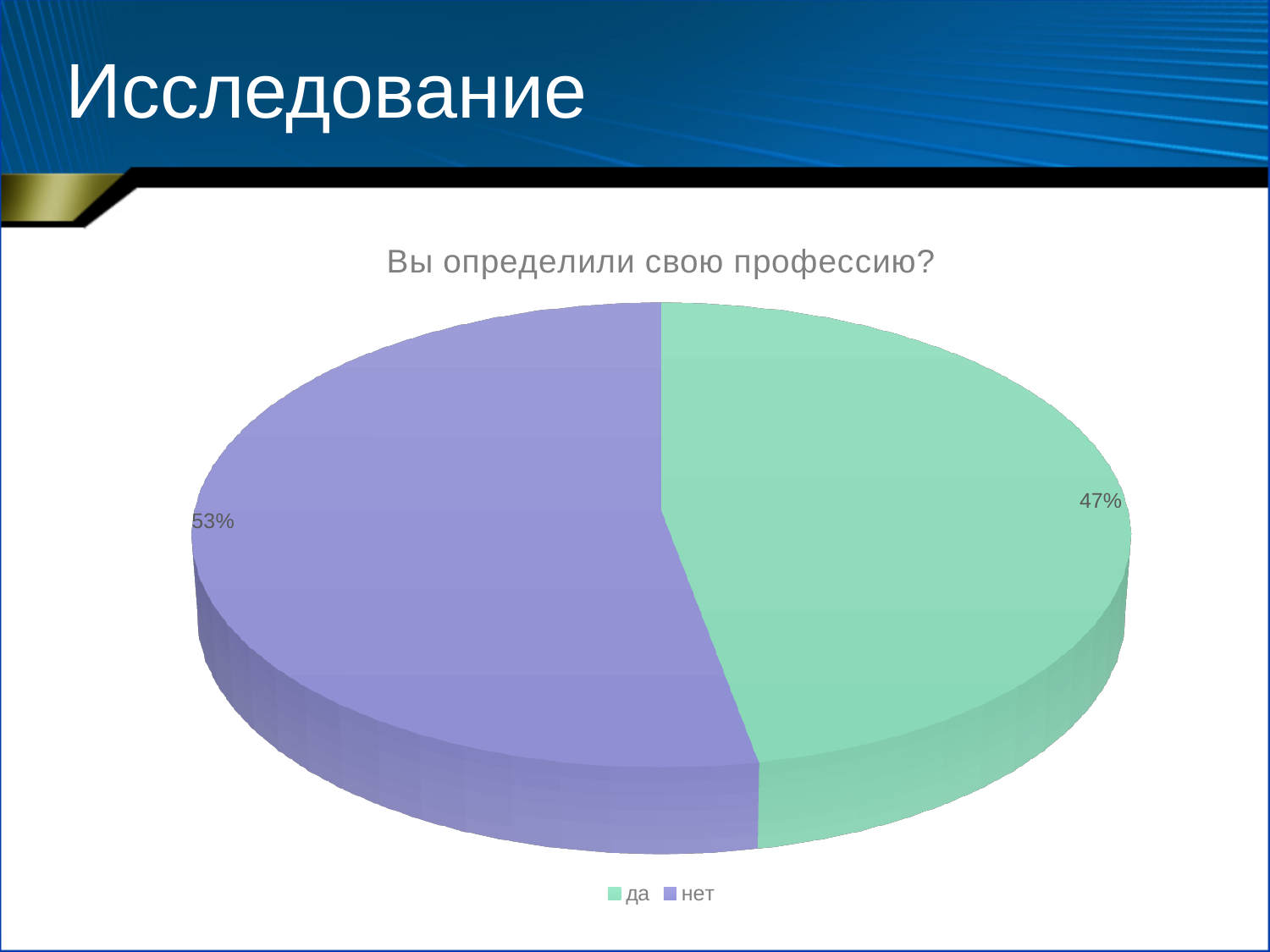
Which is larger, the "да" slice or the "нет" slice? нет What is the difference in percentage points between the "нет" and "да" slices? 6% What share of the pie does the "да" slice represent? 47% What is the title of the chart? Вы определили свою профессию? What kind of chart is shown on the slide? pie chart Which colour represents the "да" slice? green Which slice is the largest? нет Which slice is the smallest? да How many slices does the pie chart have? 2 What share of the pie does the "нет" slice represent? 53% How many entries does the legend list? 2